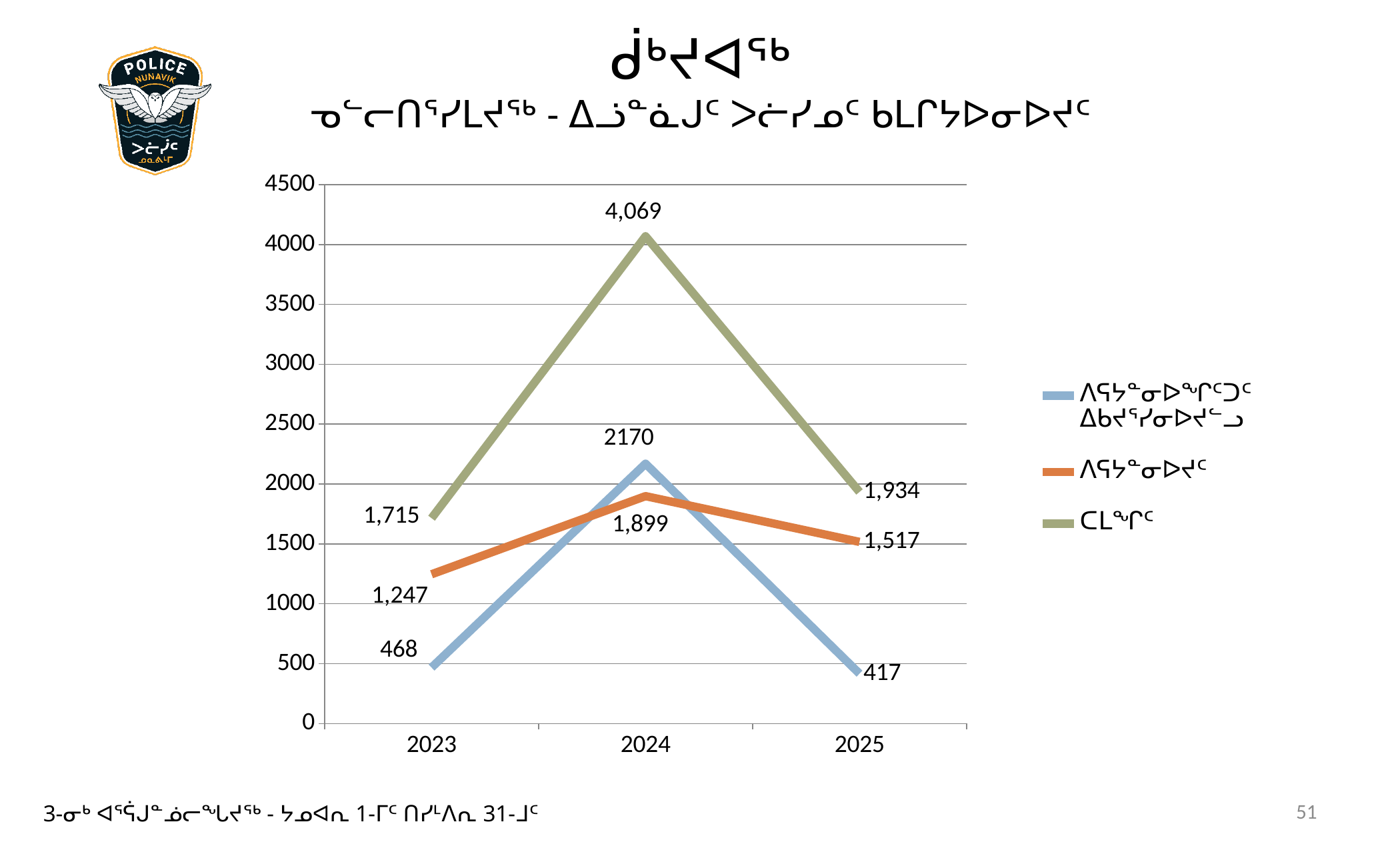
What is the value of the blue line in 2023? 468 Does the blue line rise or fall from 2024 to 2025? fall In which year does the blue line have its lowest value? 2025 In which year does the green line reach its highest value? 2024 In 2023, which is larger: the orange line's value or the green line's value? the green line How many series does the chart's legend list? 3 What kind of chart is shown on the slide? line chart What is the value of the green line in 2024? 4,069 What is the value of the orange line in 2025? 1,517 Is the green line's 2025 value greater or less than 2000? less What is the difference between the green line's 2024 value and its 2023 value? 2,354 How many years are shown on the x axis of the chart? 3